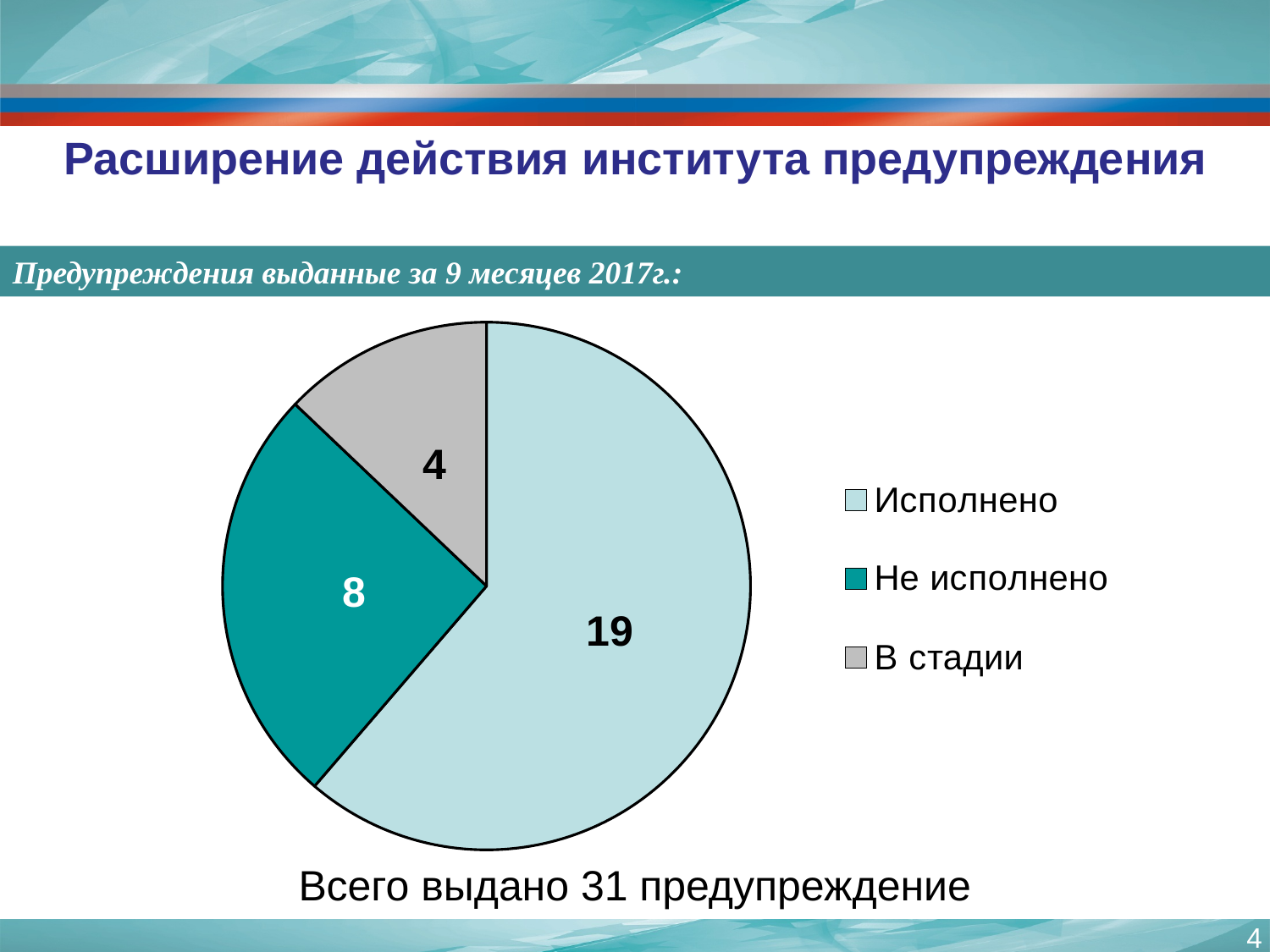
Which category has the largest slice of the pie? Исполнено What is the difference between the values for Исполнено and Не исполнено? 11 What is the value for Исполнено? 19 What is the value for В стадии? 4 What is the difference between the values for Не исполнено and В стадии? 4 What is the value for Не исполнено? 8 What type of chart is shown on the slide? pie chart Which category has the smallest slice of the pie? В стадии Which is larger, the value for Не исполнено or the value for В стадии? Не исполнено What is the total of all slices in the pie chart? 31 How many entries does the legend list? 3 How many slices does the pie chart have? 3